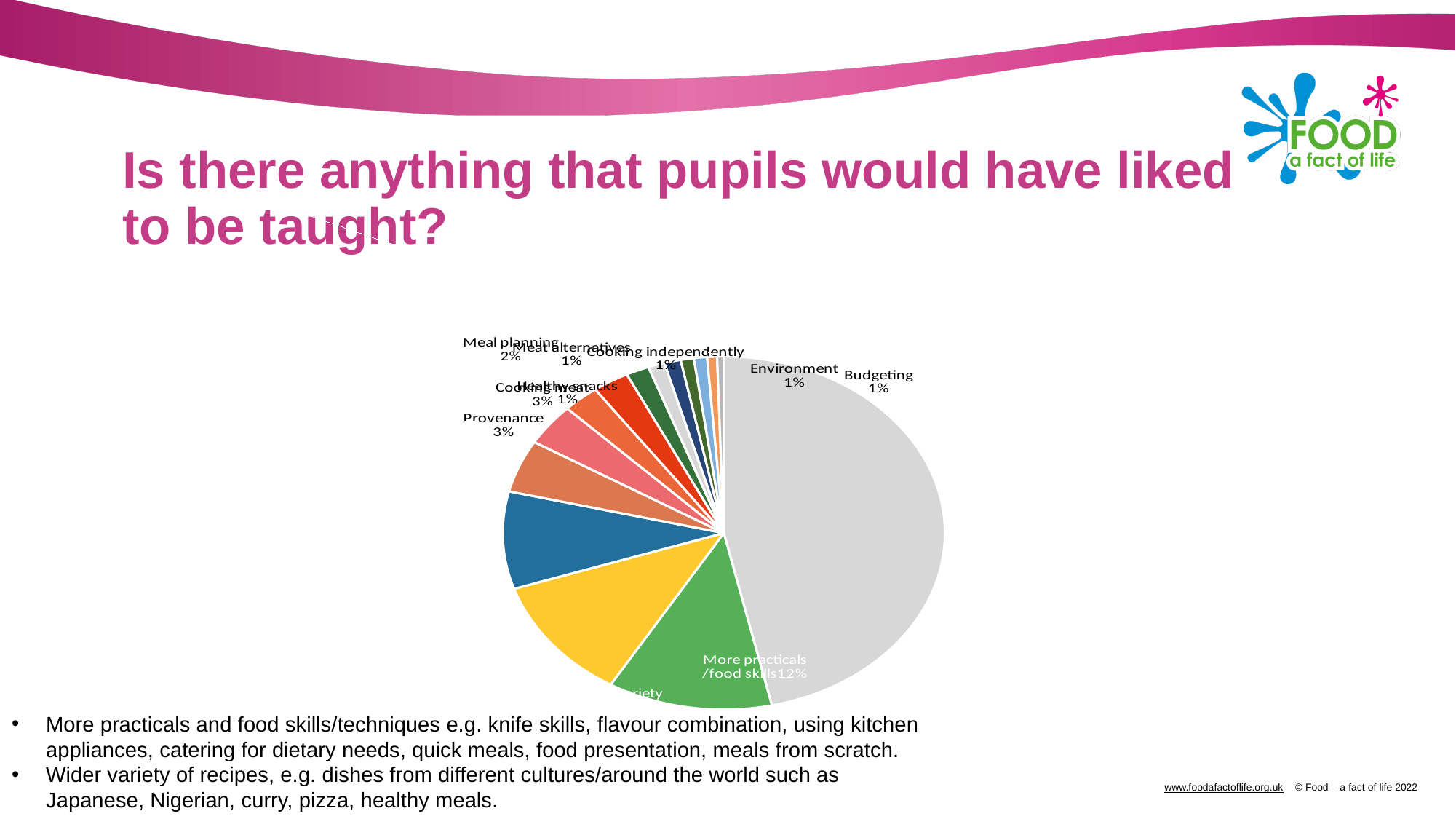
What percentage is shown for Provenance? 3% What is the difference in percentage points between More practicals/food skills and Provenance? 9% What percentage is shown for Meal planning? 2% Which has the larger share, More practicals/food skills or Meal planning? More practicals/food skills What percentage of the pie is labelled for More practicals/food skills? 12% What kind of chart is shown on the slide? pie chart What question does the slide title ask? Is there anything that pupils would have liked to be taught? What percentage is shown for Budgeting? 1% Which has the larger share, Provenance or Environment? Provenance What percentage is shown for Environment? 1% What is the difference in percentage points between Provenance and Meal planning? 1%